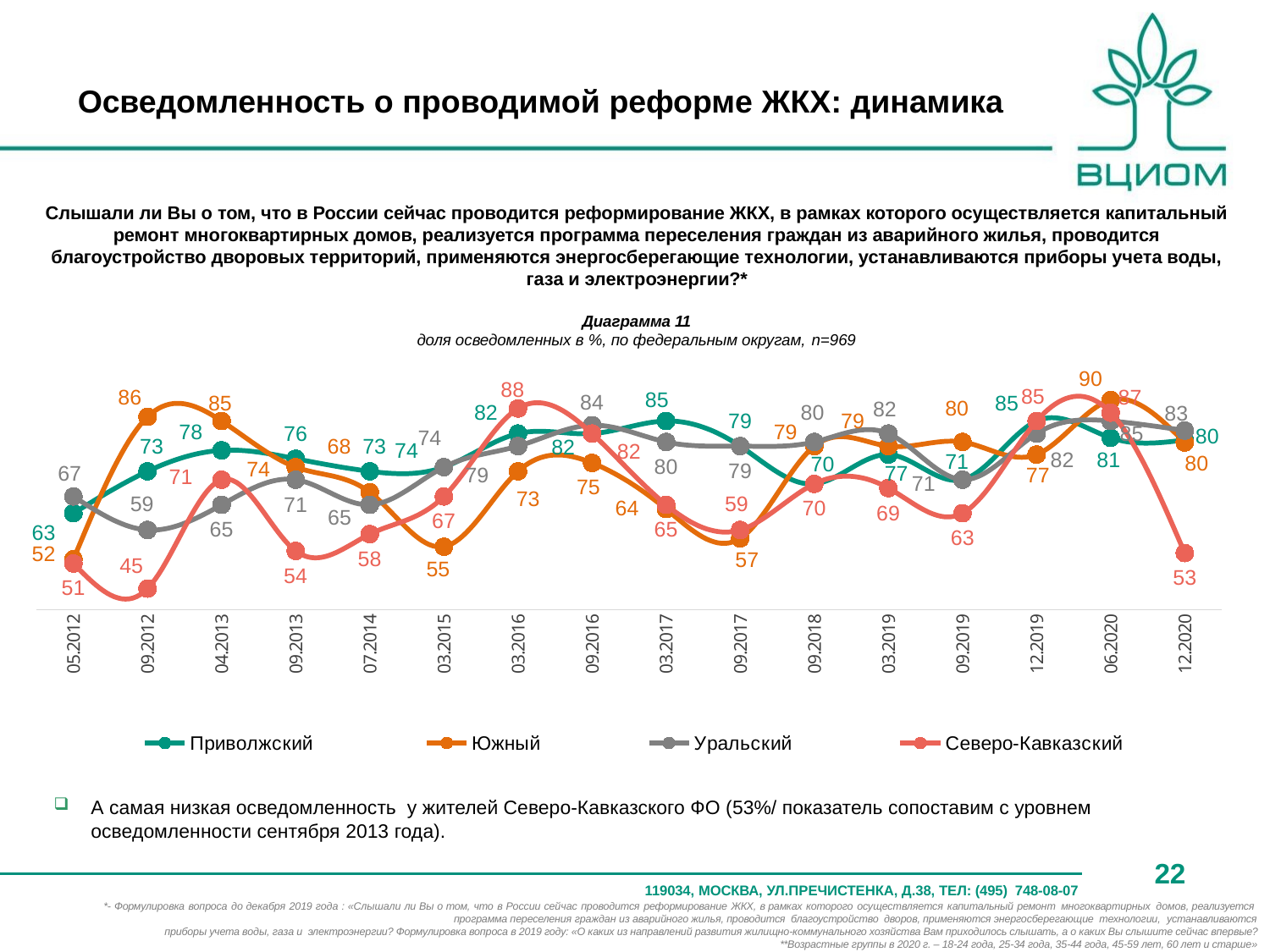
Which series has the highest value at 12.2020? Уральский What is the value for Уральский at 12.2020? 83 What is the difference between Уральский and Северо-Кавказский at 12.2020? 30 How many series does the legend list? 4 Which series has the lowest value at 12.2020? Северо-Кавказский What is the value for Северо-Кавказский at 12.2020? 53 What is the value for Северо-Кавказский at 03.2016? 88 What is the number of the diagram given in the chart title? Диаграмма 11 Does the value for Северо-Кавказский rise or fall from 06.2020 to 12.2020? fall What is the value for Южный at 06.2020? 90 How many dates are plotted along the x axis? 16 What kind of chart is shown on the slide? line chart